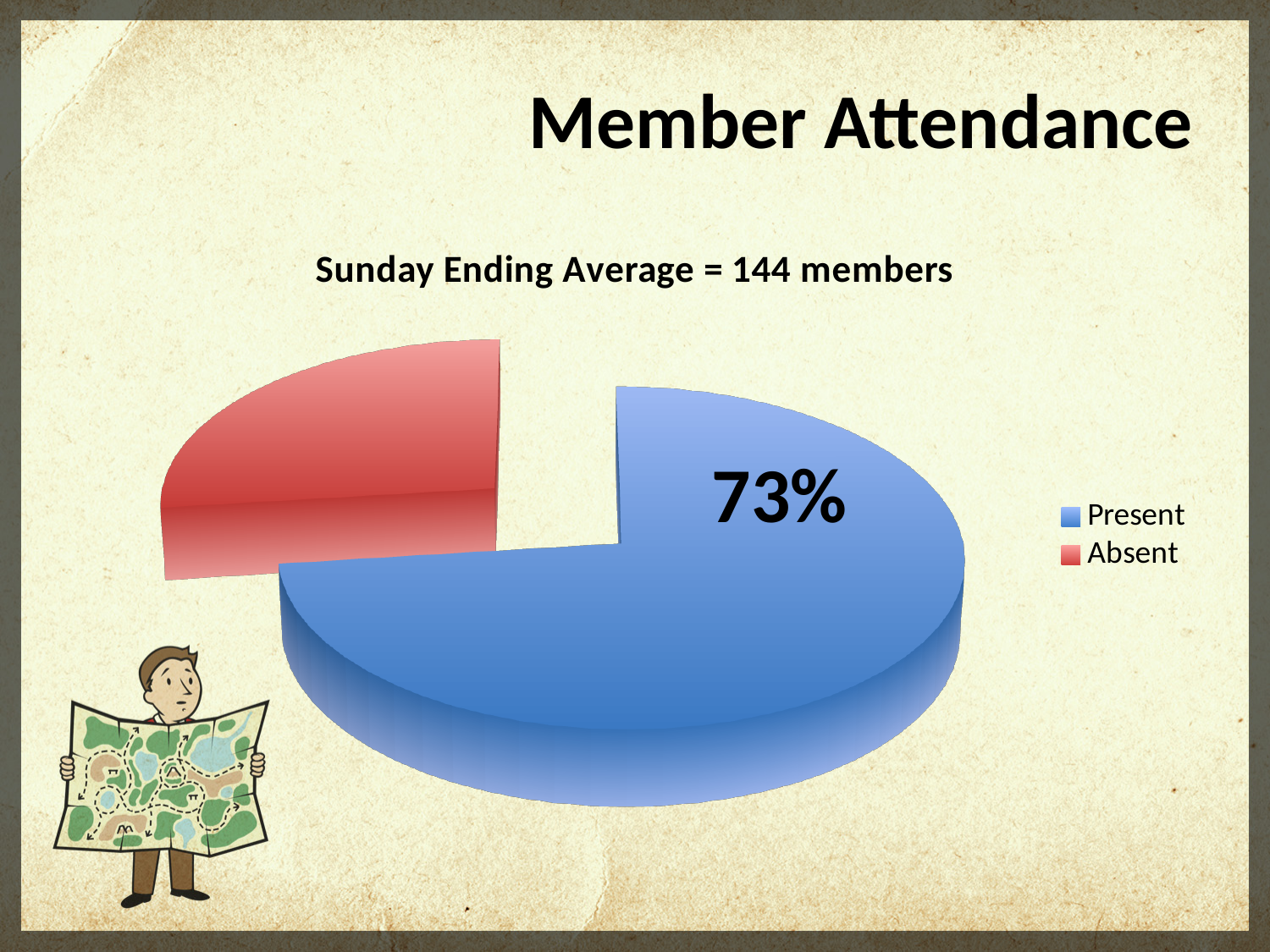
Which slice of the pie chart is the smallest? Absent How many entries does the legend list? 2 Is the share for Present greater or less than 50%? greater What colour is the Absent slice in the pie chart? red How many slices does the pie chart have? 2 What is the title shown above the pie chart? Sunday Ending Average = 144 members Which slice of the pie chart is the largest? Present What kind of chart is shown on the slide? pie chart Which is larger in the pie chart, Present or Absent? Present What percentage of members are shown as Present in the pie chart? 73% Is the share for Absent greater or less than 50%? less